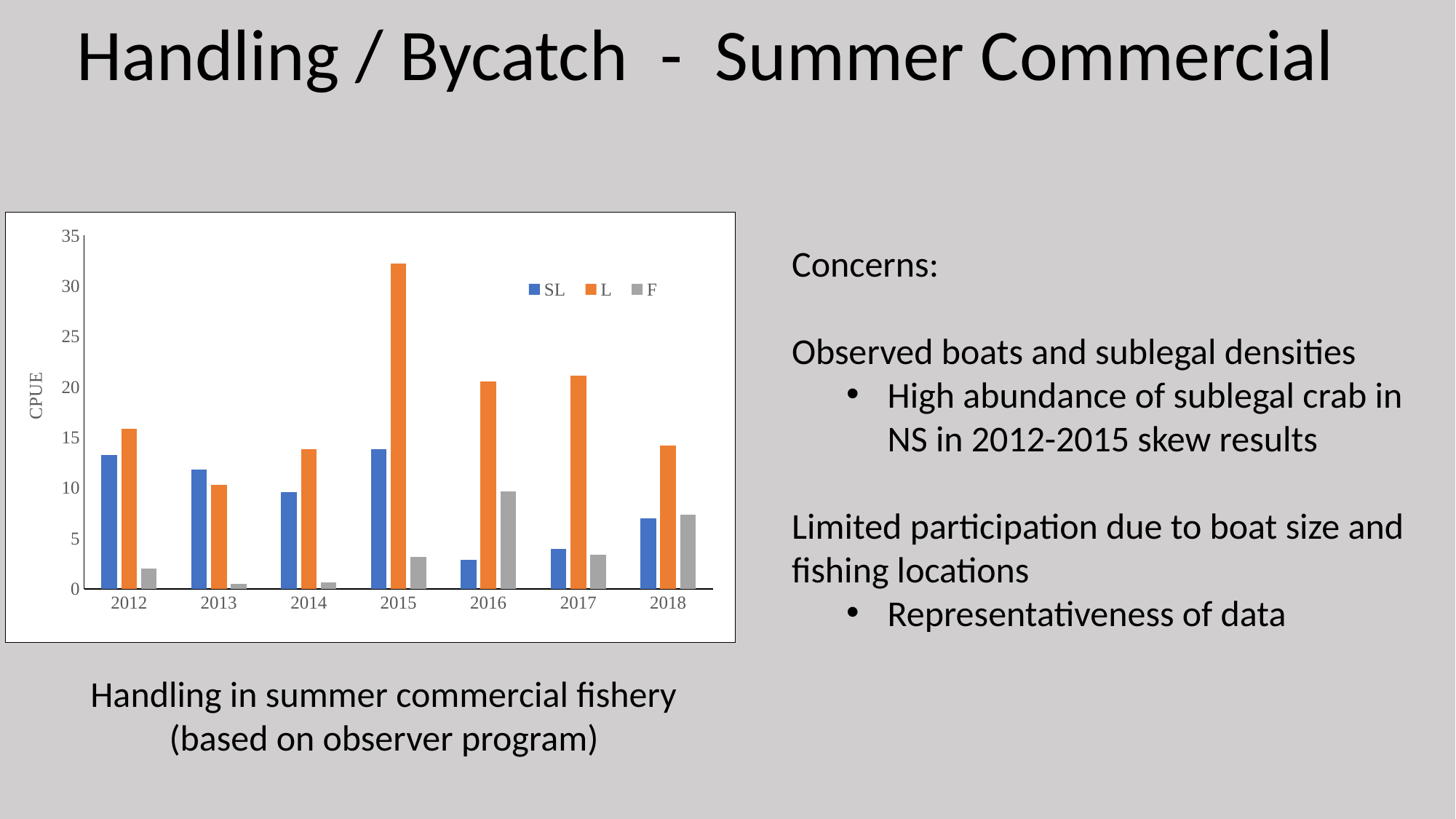
In 2016, which is larger, SL or L? L In which year is the F series highest? 2016 What is the label on the y axis of the chart? CPUE Is the value for SL in 2012 greater or less than 10? greater Is the value for L in 2015 greater or less than 30? greater Is the value for SL in 2018 greater or less than 10? less How many series does the chart's legend list? 3 What kind of chart is shown on the slide? bar chart How many years are shown on the x axis of the chart? 7 In which year is the L series highest? 2015 In 2013, which is larger, SL or L? SL